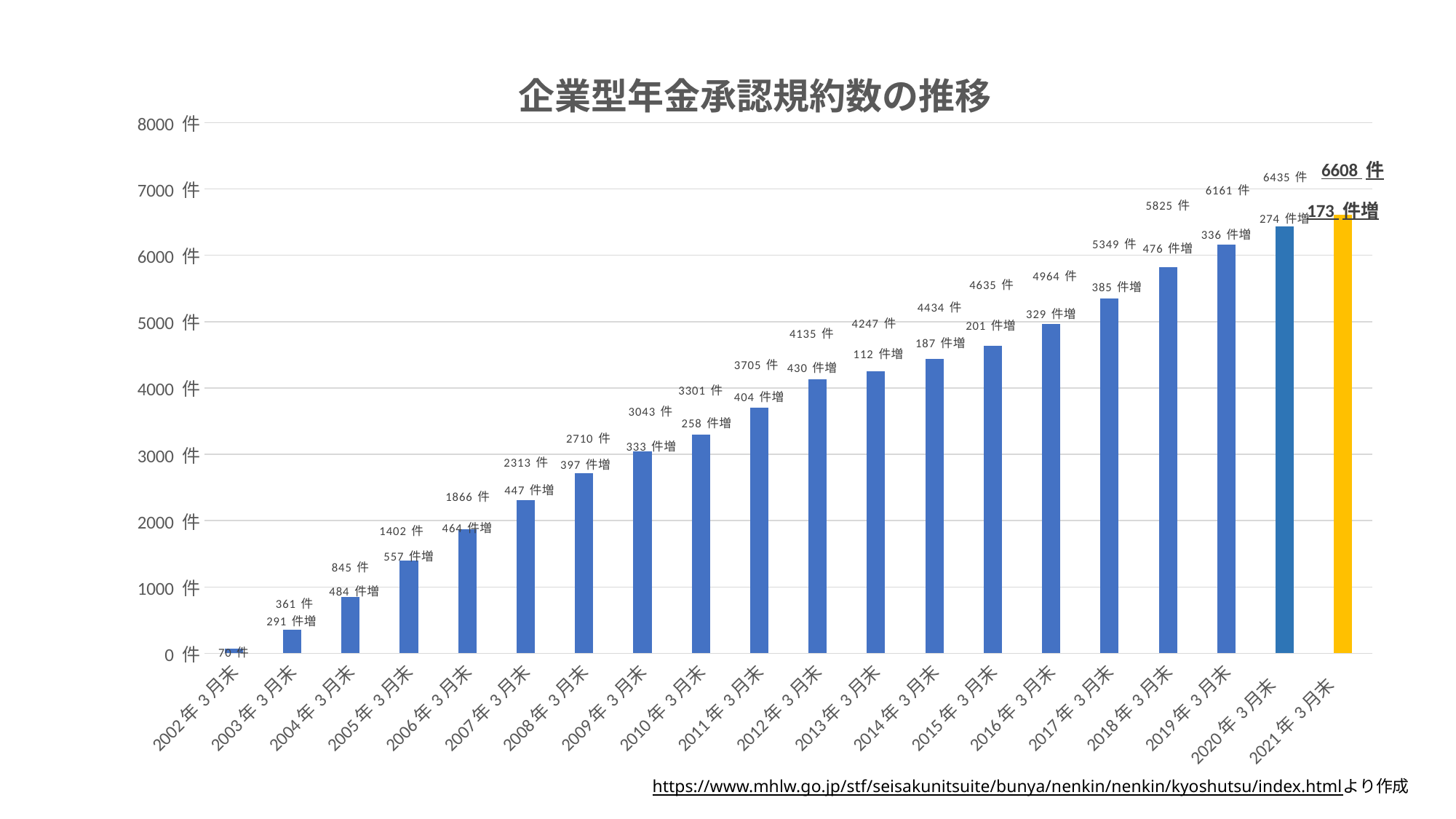
What is the difference between the values for 2020年3月末 and 2019年3月末? 274 件 What type of chart is shown on the slide? bar chart Which category has the lowest value? 2002年3月末 What is the value for 2010年3月末? 3301 件 What is the value for 2021年3月末? 6608 件 Which is larger, the value for 2013年3月末 or the value for 2012年3月末? 2013年3月末 What is the title of the chart? 企業型年金承認規約数の推移 What is the value for 2005年3月末? 1402 件 What is the increase (件増) labeled for 2018年3月末? 476 件増 Do the values rise or fall from 2002年3月末 to 2021年3月末? rise Which category has the highest value? 2021年3月末 How many bars (categories) are plotted in the chart? 20